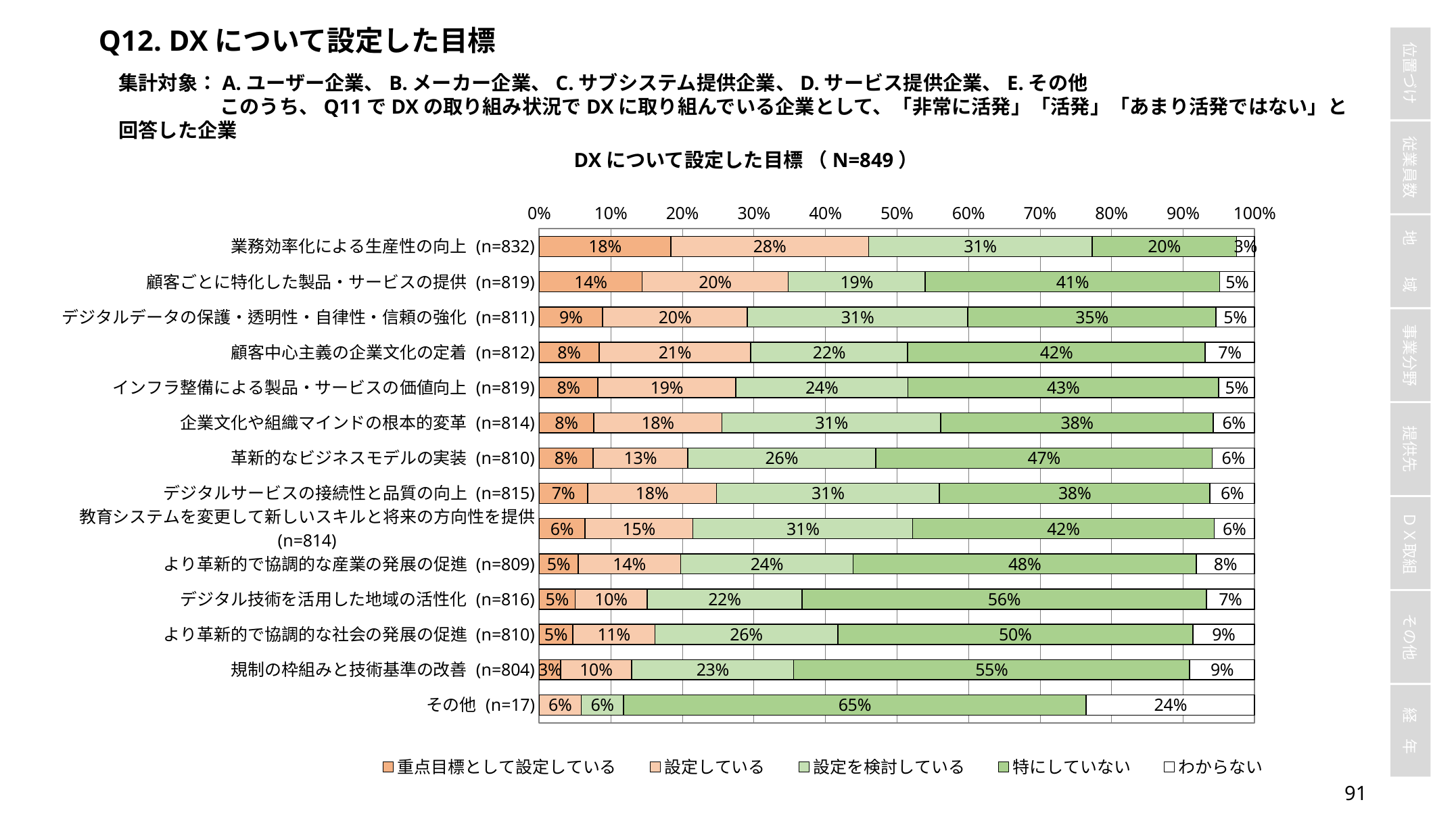
Which category has the highest value for 重点目標として設定している? 業務効率化による生産性の向上 What is the value of 特にしていない for デジタル技術を活用した地域の活性化? 56% What is the value of 重点目標として設定している for 業務効率化による生産性の向上? 18% How many series does the legend list? 5 What is the combined value of 重点目標として設定している and 設定している for 顧客ごとに特化した製品・サービスの提供? 34% Which category has the lowest value for 重点目標として設定している? その他 What is the difference between the 特にしていない values for 規制の枠組みと技術基準の改善 and 業務効率化による生産性の向上? 35% What kind of chart is shown on the slide? Stacked bar chart What is the value of わからない for その他? 24% How many categories (bars) are plotted in the chart? 14 What is the N value shown in the chart title? N=849 Which is larger: the 設定している value for 顧客中心主義の企業文化の定着 or for 革新的なビジネスモデルの実装? 顧客中心主義の企業文化の定着